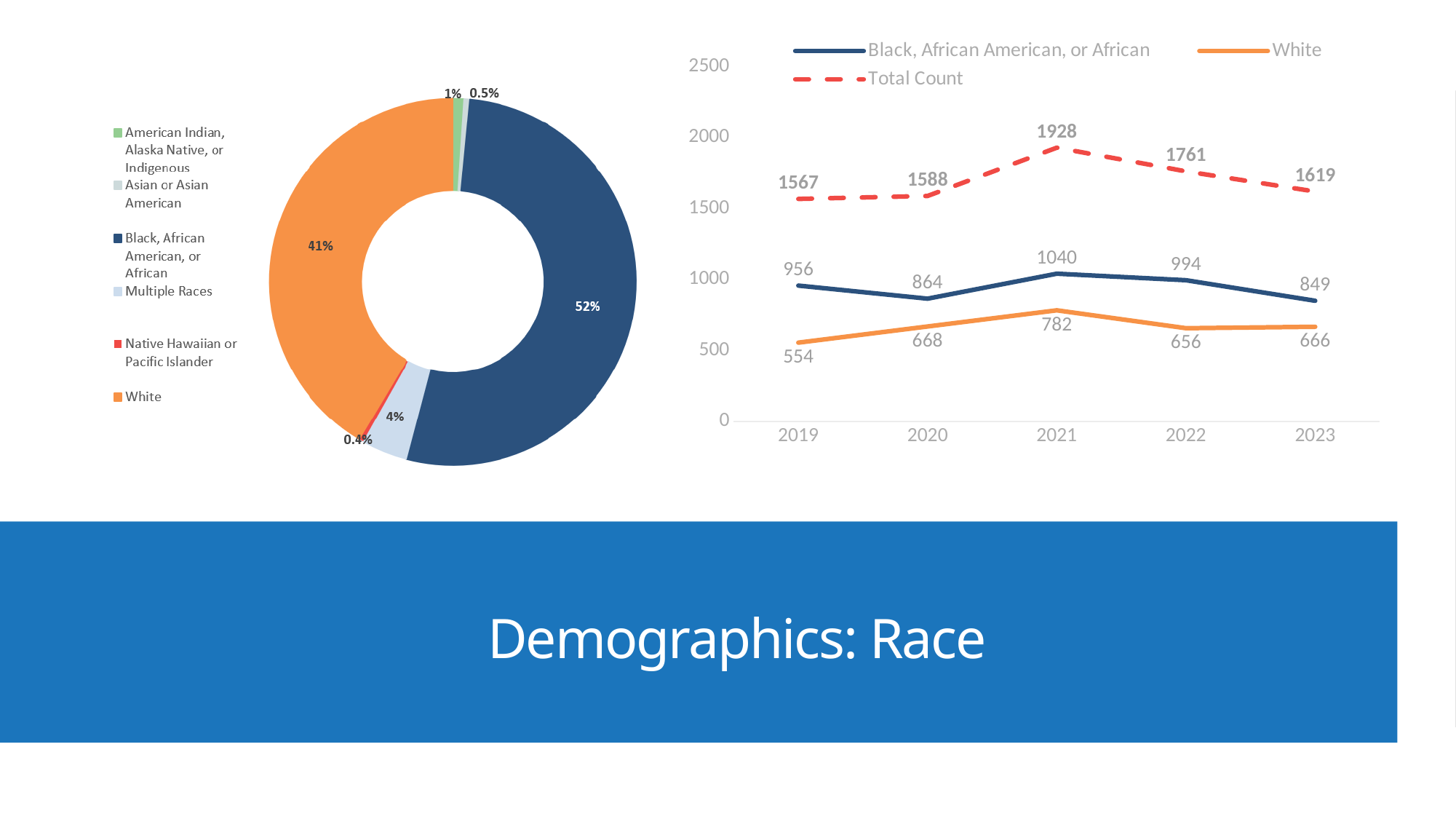
In the pie chart on the left, how many categories does the legend list? 6 In the line chart on the right, what is the Total Count value for 2021? 1928 In the pie chart on the left, what share is labelled for White? 41% In the line chart on the right, in which year is the Total Count highest? 2021 In the line chart on the right, what is the value for White in 2019? 554 In the pie chart on the left, what share is labelled for Multiple Races? 4% What kind of chart is shown on the right side of the slide? Line chart In the line chart on the right, what is the value for Black, African American, or African in 2023? 849 In the pie chart on the left, which category has the largest slice? Black, African American, or African In the pie chart on the left, what share is labelled for Black, African American, or African? 52% In the line chart on the right, what is the difference between the Black, African American, or African value and the White value in 2021? 258 In the line chart on the right, how many series does the legend list? 3